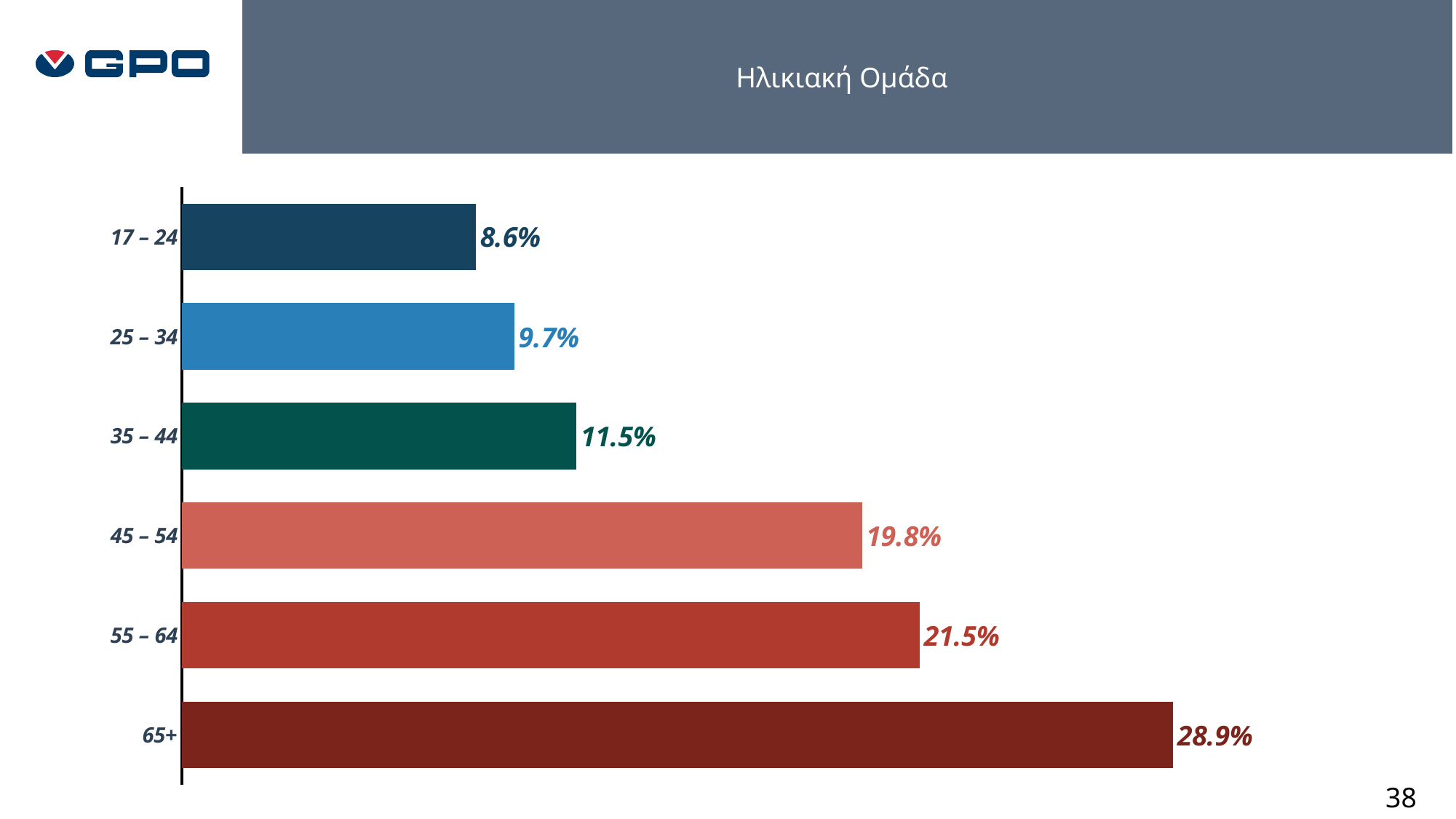
What is the value for the 45 – 54 age group? 19.8% Which has a larger value, 45 – 54 or 35 – 44? 45 – 54 Which age group has the highest value? 65+ Which age group has the lowest value? 17 – 24 What is the difference between the values for 65+ and 55 – 64? 7.4% Do the values rise or fall as the age groups get older, from 17 – 24 to 65+? Rise What is the title of the chart? Ηλικιακή Ομάδα What is the value for the 17 – 24 age group? 8.6% What is the difference between the values for 35 – 44 and 25 – 34? 1.8% What kind of chart is shown on the slide? Bar chart What is the value for the 65+ age group? 28.9% How many age groups are shown in the chart? 6